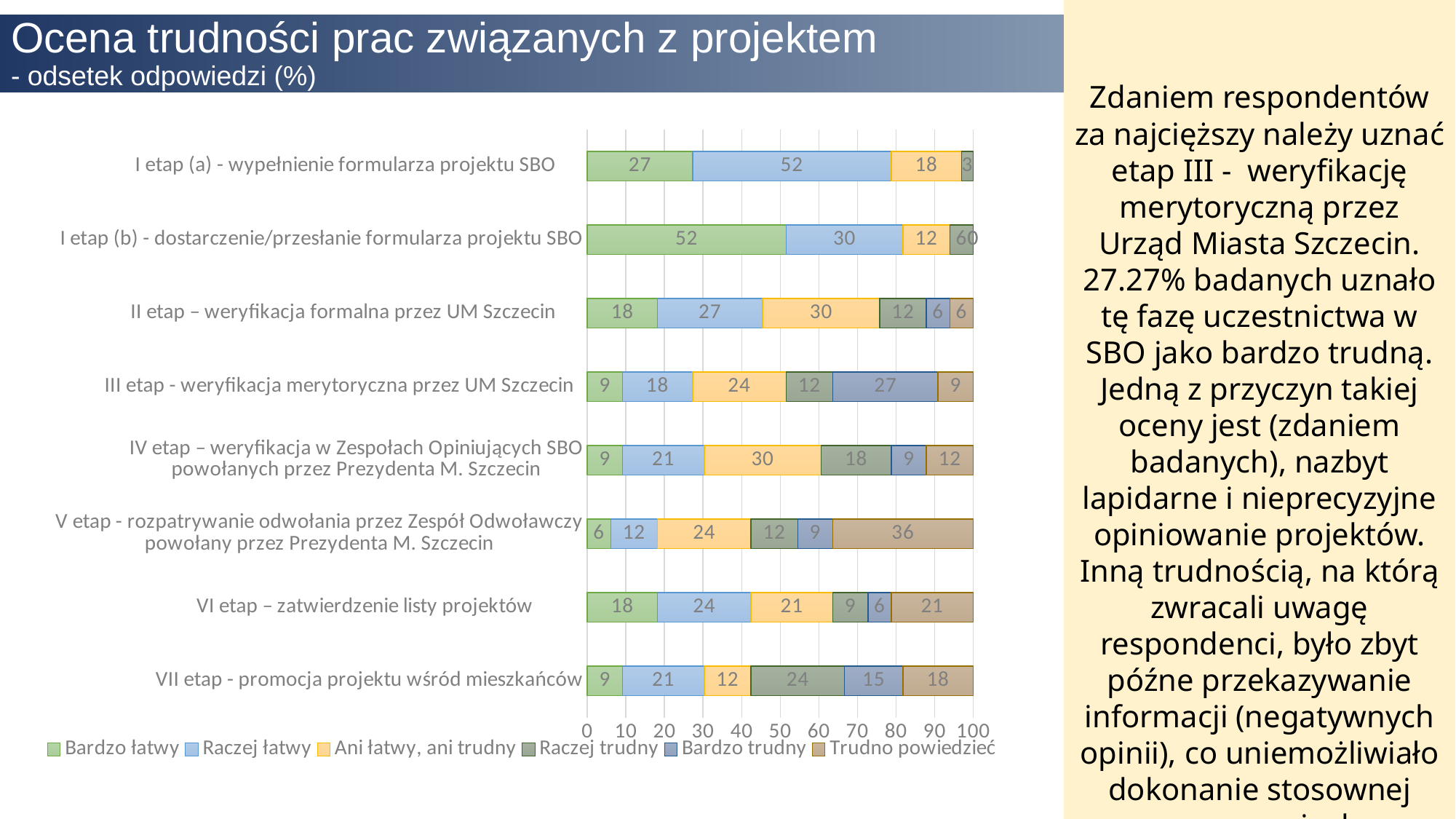
Which stage has the highest 'Bardzo trudny' value? III etap - weryfikacja merytoryczna przez UM Szczecin What is the value of 'Trudno powiedzieć' for 'V etap - rozpatrywanie odwołania przez Zespół Odwoławczy powołany przez Prezydenta M. Szczecin'? 36 What is the difference between the 'Raczej łatwy' values for 'I etap (a)' and 'I etap (b)'? 22 Which stage has the highest 'Bardzo łatwy' value? I etap (b) - dostarczenie/przesłanie formularza projektu SBO What colour represents the 'Ani łatwy, ani trudny' series in the legend? yellow What is the value of 'Ani łatwy, ani trudny' for 'IV etap – weryfikacja w Zespołach Opiniujących SBO powołanych przez Prezydenta M. Szczecin'? 30 How many series does the legend list? 6 What is the value of 'Raczej łatwy' for 'I etap (a) - wypełnienie formularza projektu SBO'? 52 What kind of chart is shown on the slide? stacked bar chart Which is larger: the 'Raczej trudny' value for 'VII etap - promocja projektu wśród mieszkańców' or for 'VI etap – zatwierdzenie listy projektów'? VII etap - promocja projektu wśród mieszkańców What is the value of 'Bardzo trudny' for 'III etap - weryfikacja merytoryczna przez UM Szczecin'? 27 How many stages (categories) are plotted on the chart? 8